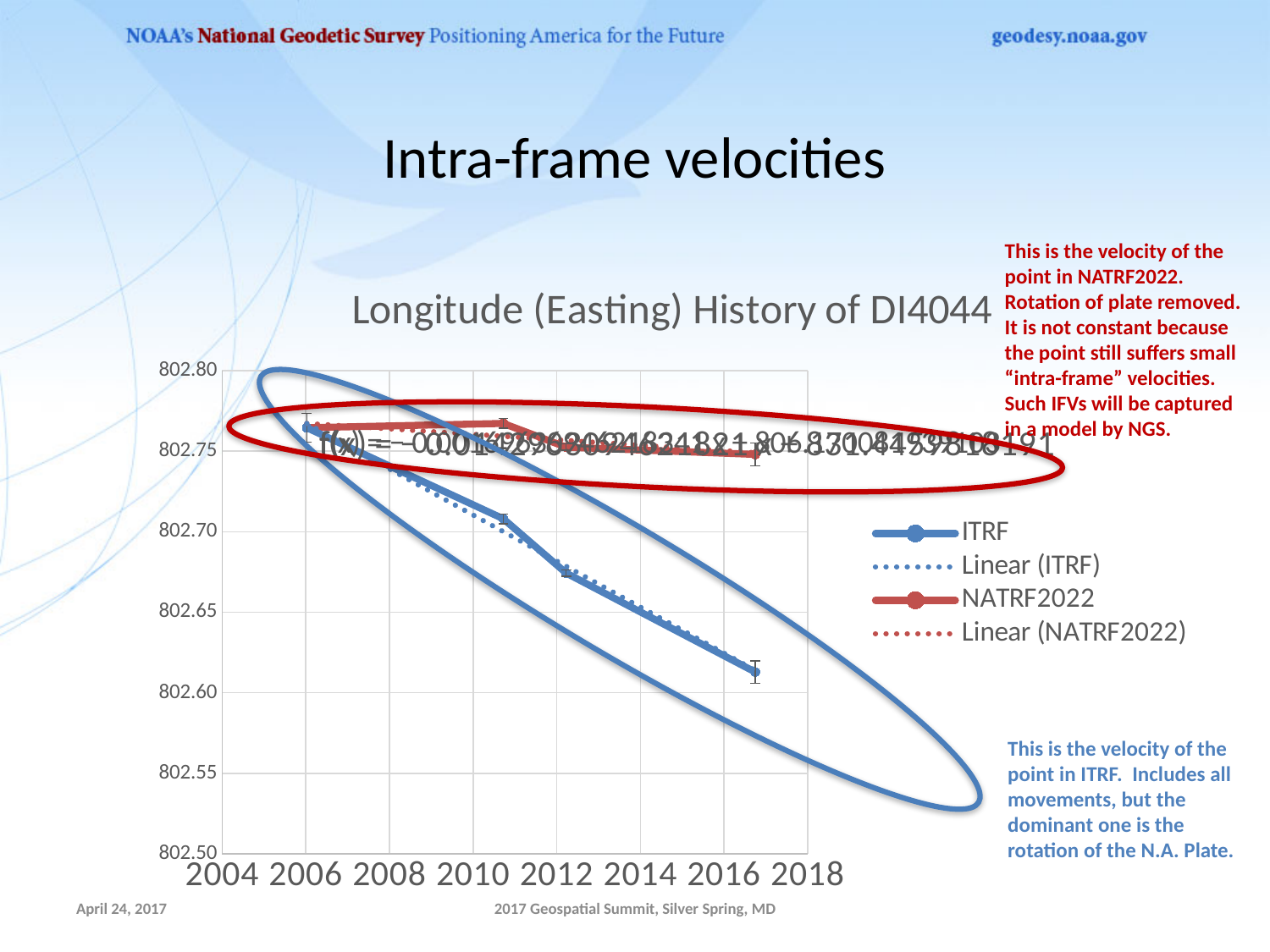
Do the ITRF values rise or fall from 2006 to 2017? fall What is the title of the chart? Longitude (Easting) History of DI4044 What kind of chart is shown on the slide? line chart Which series shows the larger drop in value between 2006 and 2017, ITRF or NATRF2022? ITRF At 2017, which series has the higher value, ITRF or NATRF2022? NATRF2022 Is the NATRF2022 value at 2017 greater or less than 802.70? greater Which colour is used for the NATRF2022 series in the chart? red Is the ITRF value at 2017 greater or less than 802.65? less Is the ITRF value at 2012 greater or less than 802.70? less How many series does the chart legend list? 4